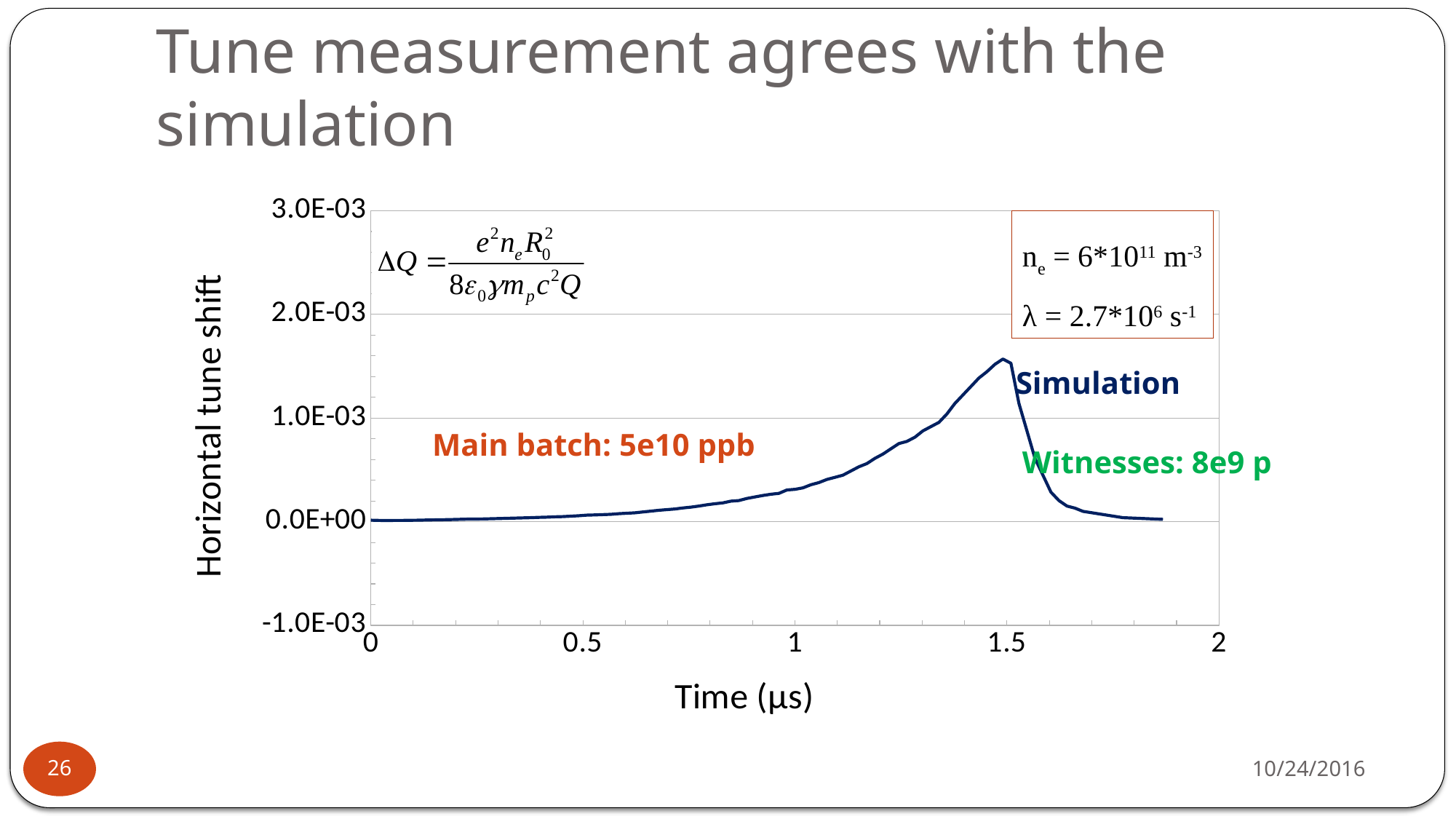
What is the x-axis label of the chart? Time (µs) Does the horizontal tune shift rise or fall between time 0 and time 1.5 µs? rise Is the horizontal tune shift at time 1.5 µs greater or less than 1.0E-03? greater What kind of chart is shown on the slide? line chart Is the horizontal tune shift at time 1.5 µs greater or less than 2.0E-03? less Is the horizontal tune shift at time 0.5 µs greater or less than 1.0E-03? less Which is larger, the horizontal tune shift at time 1 µs or at time 1.5 µs? 1.5 µs Near which x-axis tick does the Simulation curve reach its maximum? 1.5 What is the label of the plotted series in the chart? Simulation Does the horizontal tune shift rise or fall between time 1.5 µs and time 1.75 µs? fall